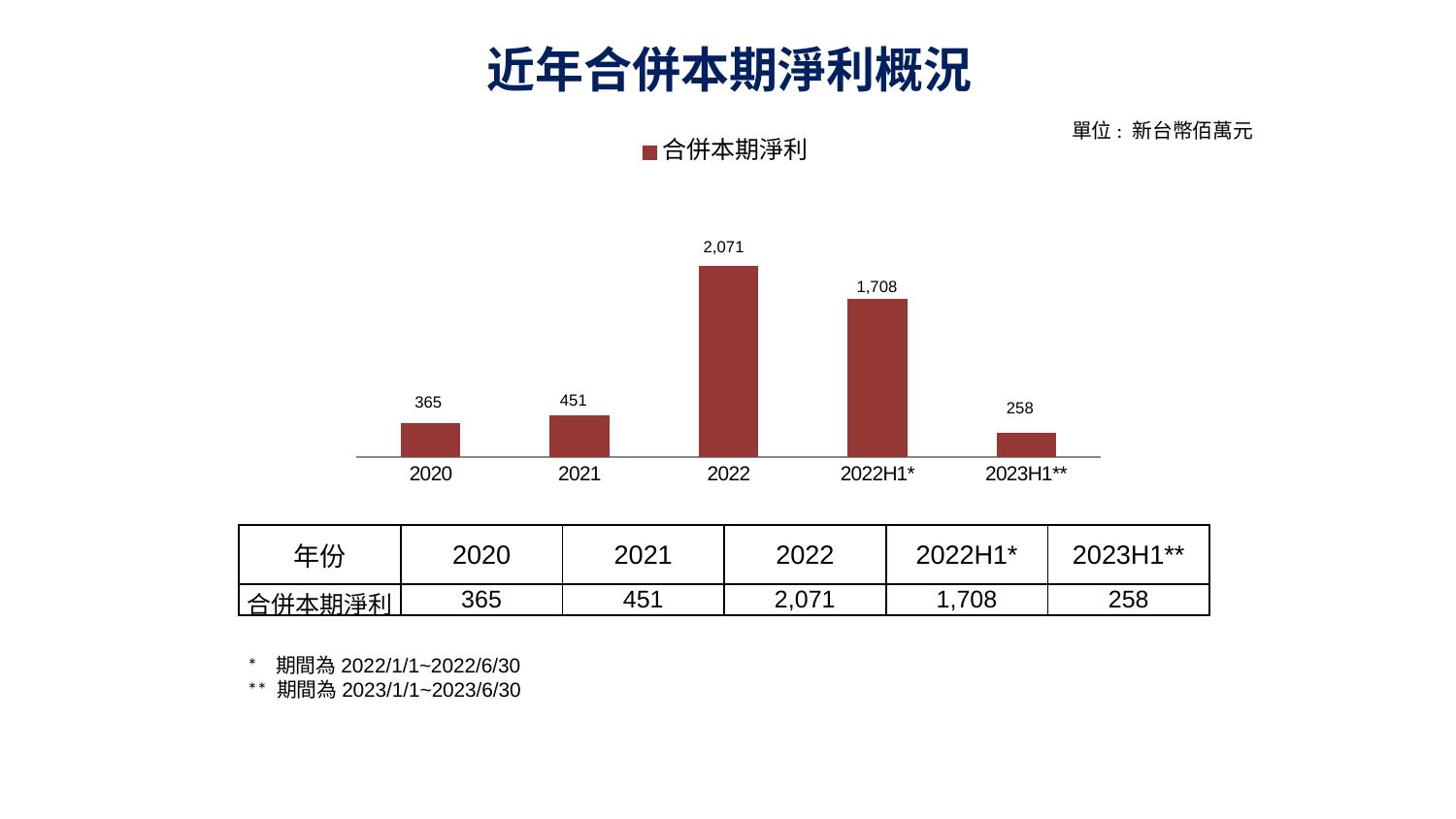
What unit is stated for the values in the chart? 新台幣佰萬元 What is the difference between the 合併本期淨利 for 2021 and 2020? 86 What is the value of 合併本期淨利 for 2020? 365 What is the value of 合併本期淨利 for 2023H1**? 258 What is the value of 合併本期淨利 for 2022? 2,071 Which category has the highest 合併本期淨利? 2022 How many series does the legend list? 1 What kind of chart is shown on the slide? bar chart How many categories are shown on the x axis of the chart? 5 Which is larger, the 合併本期淨利 for 2022H1* or for 2023H1**? 2022H1* Which category has the lowest 合併本期淨利? 2023H1** What is the difference between the 合併本期淨利 for 2022 and 2022H1*? 363